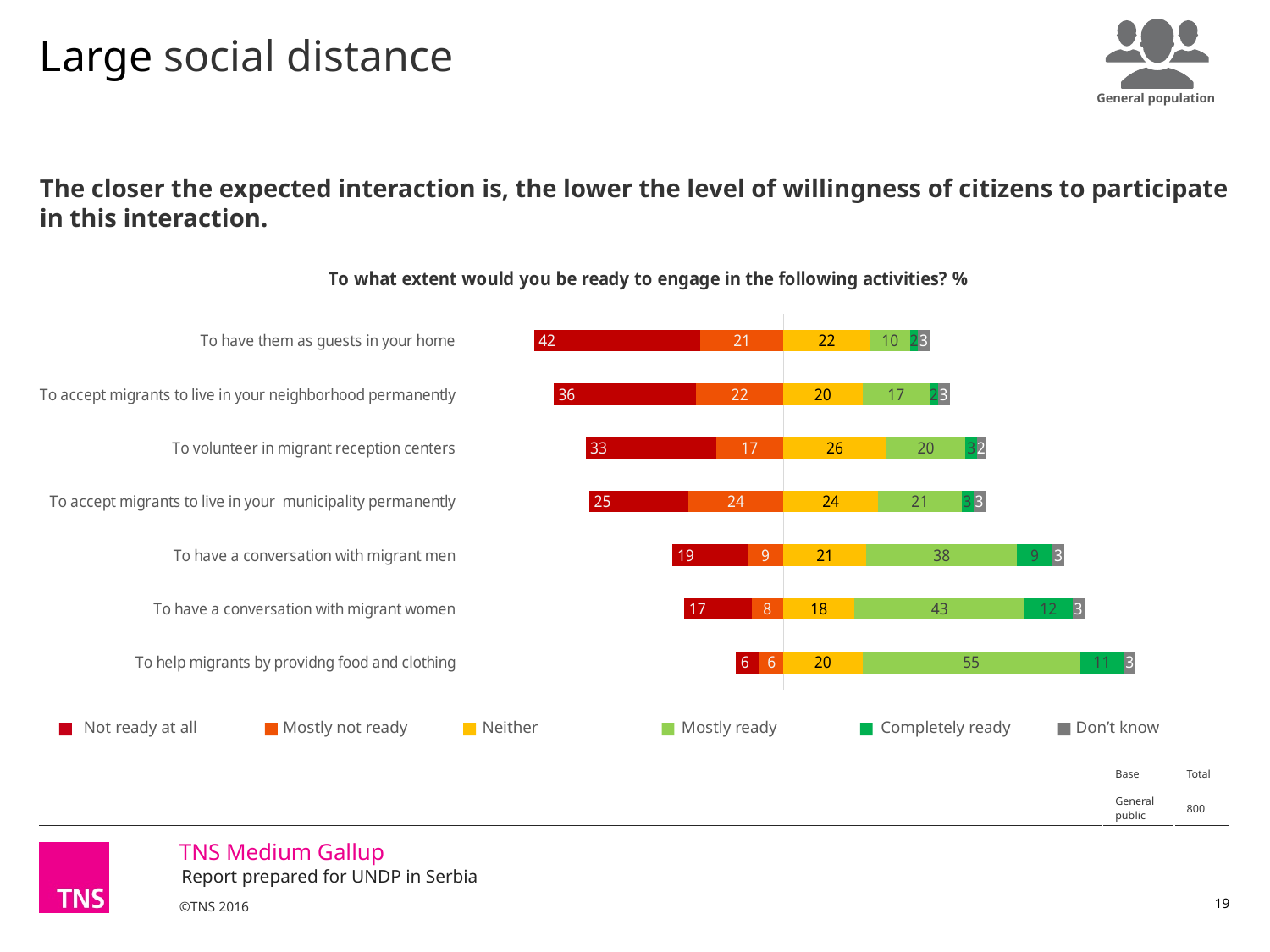
Which activity has the highest "Not ready at all" value? To have them as guests in your home What is the title of the chart? To what extent would you be ready to engage in the following activities? % What kind of chart is shown on the slide? Stacked bar chart What is the "Completely ready" value for "To have a conversation with migrant women"? 12 What is the "Mostly ready" value for "To help migrants by providng food and clothing"? 55 Which has the larger "Neither" value: "To volunteer in migrant reception centers" or "To accept migrants to live in your municipality permanently"? To volunteer in migrant reception centers How much higher is the "Mostly ready" value for a conversation with migrant women than for a conversation with migrant men? 5 How many series does the legend list? 6 Which activity has the lowest "Not ready at all" value? To help migrants by providng food and clothing How many activities are listed in the chart? 7 What is the total of the stacked bar for "To have them as guests in your home"? 100 What percentage of respondents are "Not ready at all" to have migrants as guests in their home? 42